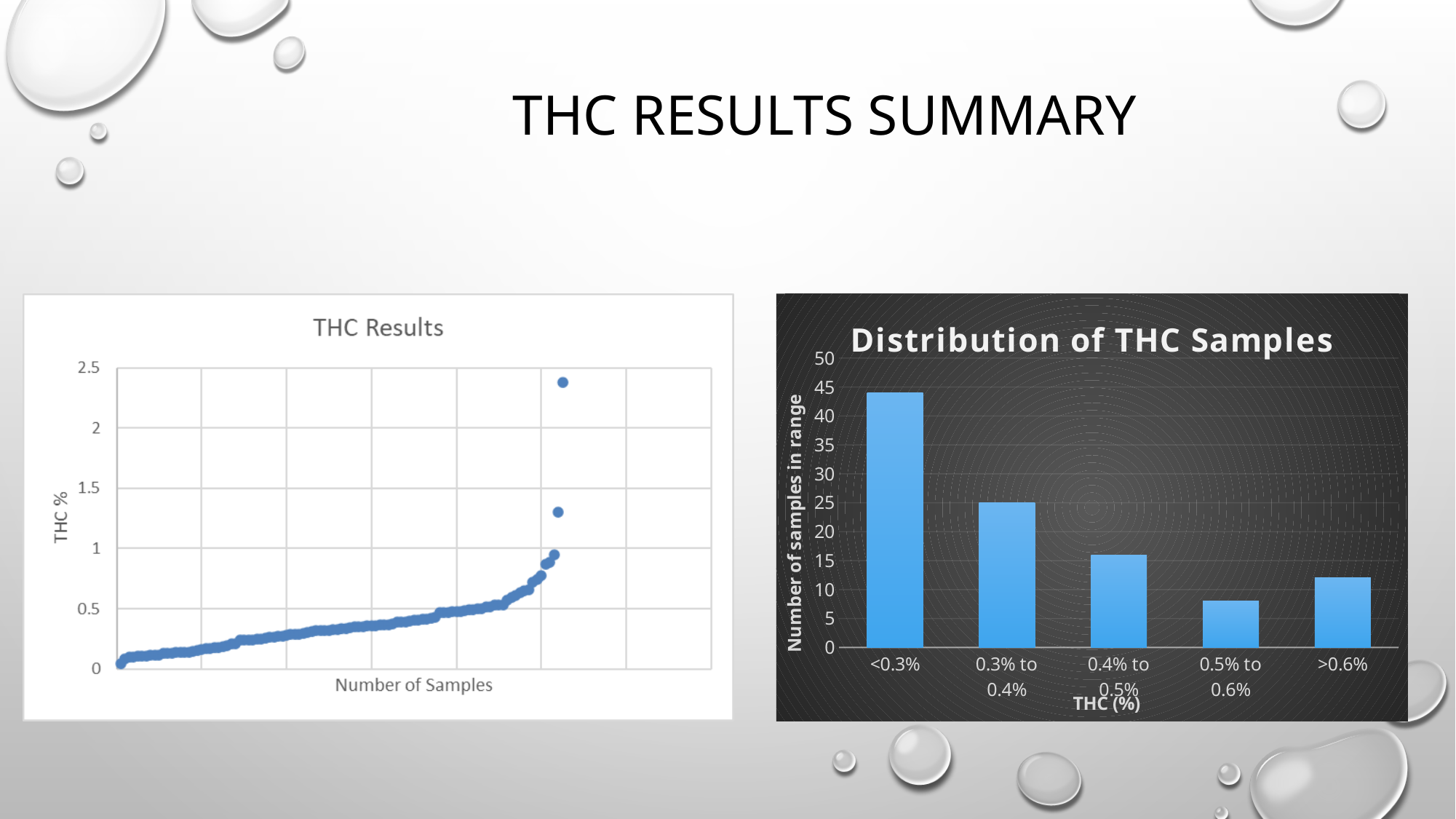
In the 'Distribution of THC Samples' chart, is the number of samples for >0.6% greater or less than 10? greater How many THC ranges are shown on the x axis of the 'Distribution of THC Samples' chart? 5 In the 'THC Results' chart, is the highest plotted THC % value greater or less than 2? greater In the 'Distribution of THC Samples' chart, which THC range has the highest number of samples? <0.3% In the 'Distribution of THC Samples' chart, is the number of samples for <0.3% greater or less than 40? greater What is the y-axis label of the 'Distribution of THC Samples' chart? Number of samples in range What kind of chart is the 'Distribution of THC Samples' chart on the right? bar chart In the 'Distribution of THC Samples' chart, which has more samples: 0.3% to 0.4% or >0.6%? 0.3% to 0.4% In the 'THC Results' chart, do the THC % values rise or fall from left to right along the x axis? rise What kind of chart is the 'THC Results' chart on the left? scatter chart In the 'Distribution of THC Samples' chart, which THC range has the lowest number of samples? 0.5% to 0.6%